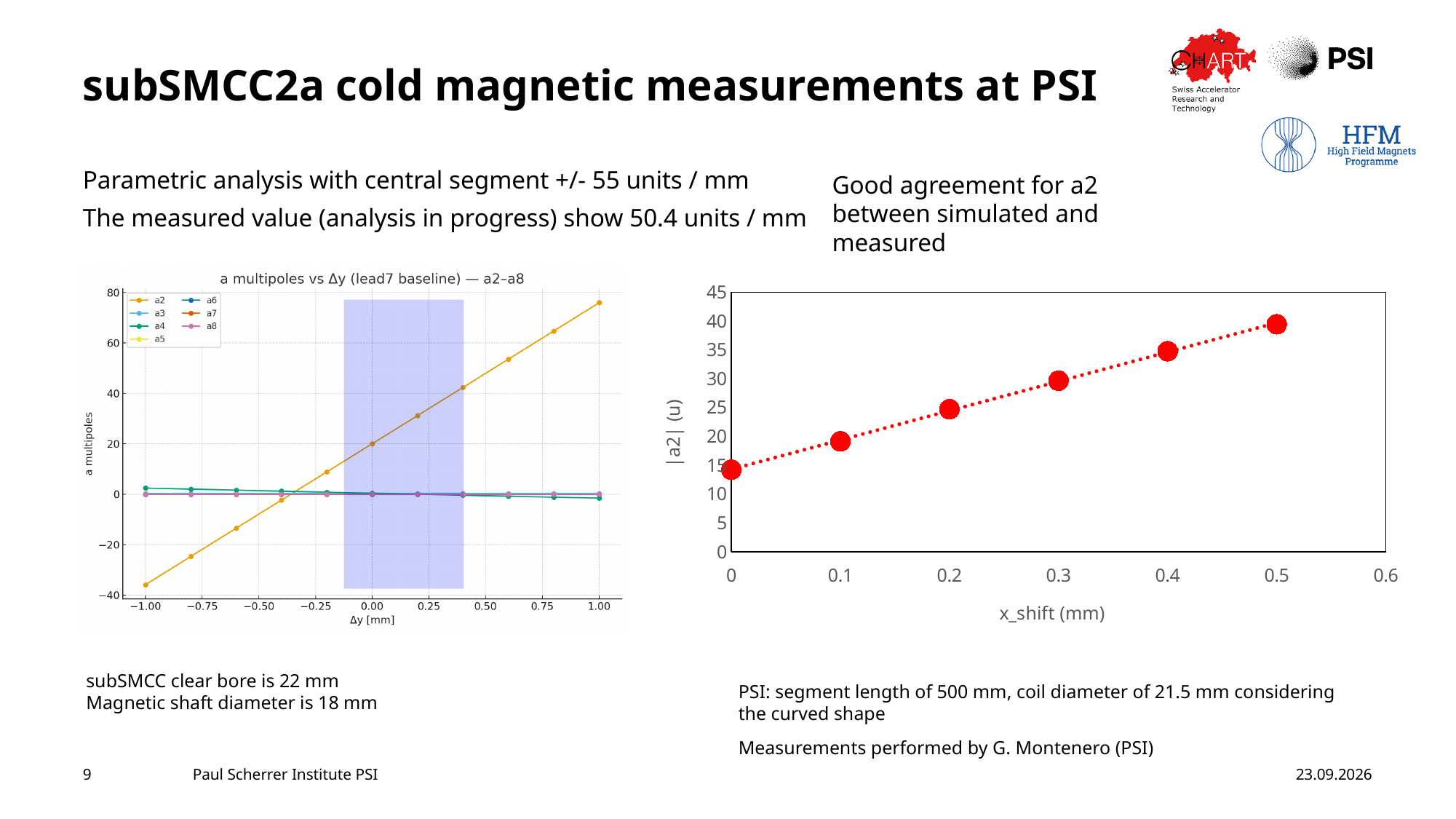
On the left chart, is the value of a2 at Δy = 1.00 greater or less than 60? greater On the right chart, is the value of |a2| at x_shift = 0 mm greater or less than 20? less On the left chart, is the value of a2 at Δy = −1.00 greater or less than −20? less On the right chart, does |a2| rise or fall as x_shift increases? rise On the right chart, how many data points are plotted? 6 On the right chart, what is the label of the x axis? x_shift (mm) On the right chart, which x_shift value has the lowest |a2|? 0 On the left chart, does the a2 series rise or fall as Δy increases from −1.00 to 1.00? rise On the left chart, how many series does the legend list? 7 On the left chart, what is the title? a multipoles vs Δy (lead7 baseline) — a2–a8 On the left chart, which series has the highest value at Δy = 1.00? a2